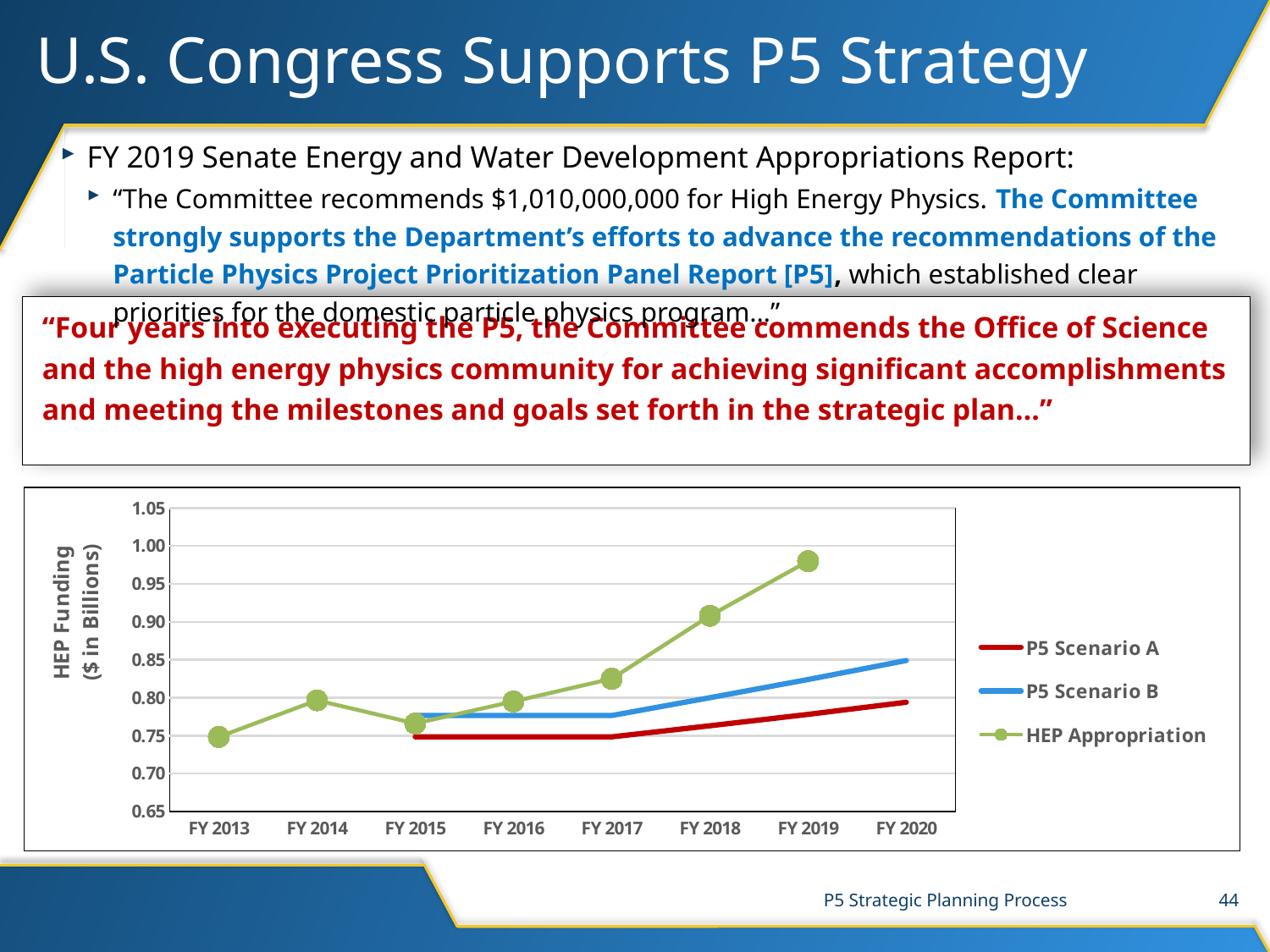
Is the P5 Scenario B value for FY 2020 greater or less than 0.80? greater What kind of chart is shown on the slide? line chart At FY 2019, which is larger: the HEP Appropriation value or the P5 Scenario B value? HEP Appropriation How many data points are plotted for the HEP Appropriation series? 7 In which fiscal year is the HEP Appropriation value highest? FY 2019 How many fiscal years are shown on the x axis of the chart? 8 How many series does the chart legend list? 3 At FY 2020, which is larger: P5 Scenario A or P5 Scenario B? P5 Scenario B What is the label on the y axis of the chart? HEP Funding ($ in Billions) Is the HEP Appropriation value for FY 2019 greater or less than 0.95? greater Does the HEP Appropriation series rise or fall from FY 2015 to FY 2019? rise Is the HEP Appropriation value for FY 2013 greater or less than 0.80? less